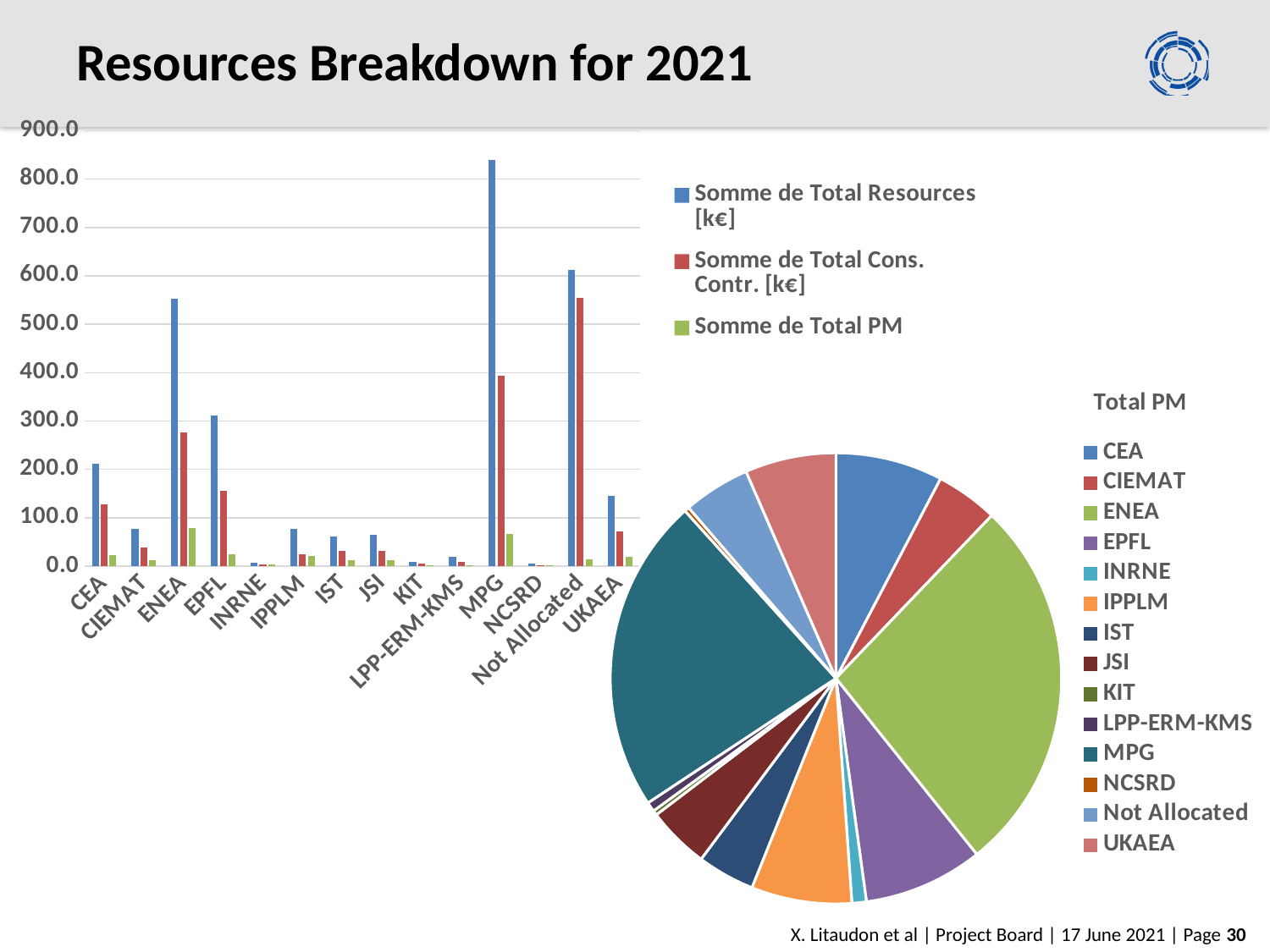
In the bar chart on the left, is the 'Somme de Total Cons. Contr. [k€]' value for CEA greater or less than 200? less In the bar chart on the left, how many series does the legend list? 3 In the bar chart on the left, is the 'Somme de Total Resources [k€]' value for ENEA greater or less than 500? greater What kind of chart is the chart titled 'Total PM'? pie chart In the bar chart on the left, is the 'Somme de Total Resources [k€]' value for MPG greater or less than 800? greater In the bar chart on the left, which category has the highest value for 'Somme de Total Resources [k€]'? MPG In the bar chart on the left, how many categories are shown on the x axis? 14 In the pie chart titled 'Total PM', which slice is larger, ENEA or CEA? ENEA In the bar chart on the left, which has the larger 'Somme de Total Resources [k€]' value, ENEA or EPFL? ENEA What kind of chart is the chart on the left of the slide? bar chart In the bar chart on the left, which has the larger 'Somme de Total Cons. Contr. [k€]' value, Not Allocated or MPG? Not Allocated